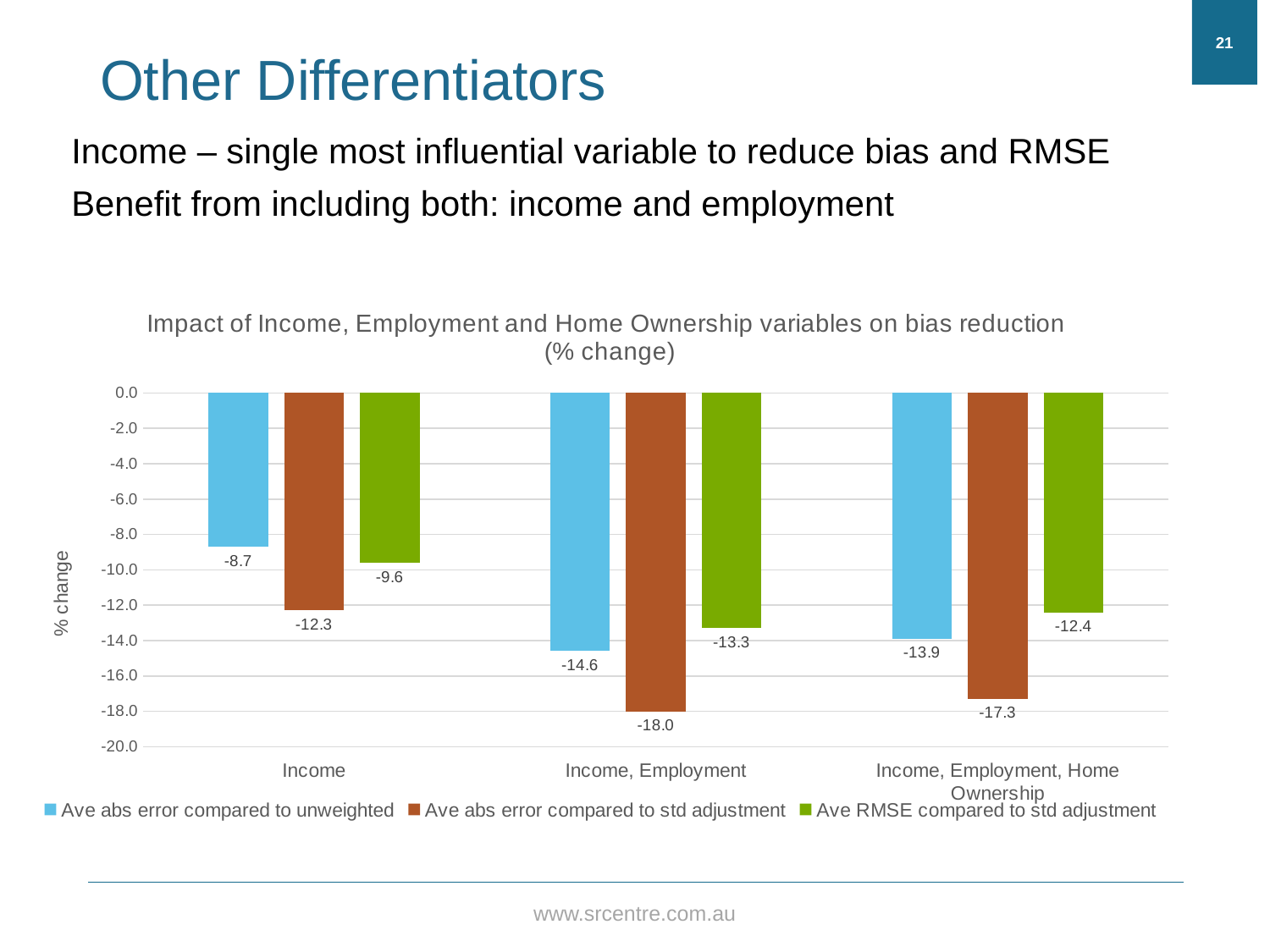
Which category has the lowest value for 'Ave abs error compared to std adjustment'? Income, Employment How many series does the legend list? 3 Which is larger: the 'Ave RMSE compared to std adjustment' value for Income or for Income, Employment? Income How many categories are shown on the x axis? 3 What is the difference between the 'Ave abs error compared to std adjustment' values for Income, Employment and Income? 5.7 Which category has the highest (least negative) value for 'Ave abs error compared to unweighted'? Income Is the value of 'Ave abs error compared to unweighted' for Income, Employment greater or less than -12.0? less What is the value of 'Ave RMSE compared to std adjustment' for the Income, Employment, Home Ownership category? -12.4 What is the value of 'Ave abs error compared to unweighted' for the Income category? -8.7 What kind of chart is shown on the slide? bar chart What is the value of 'Ave abs error compared to std adjustment' for the Income, Employment category? -18.0 What is the label of the y axis? % change